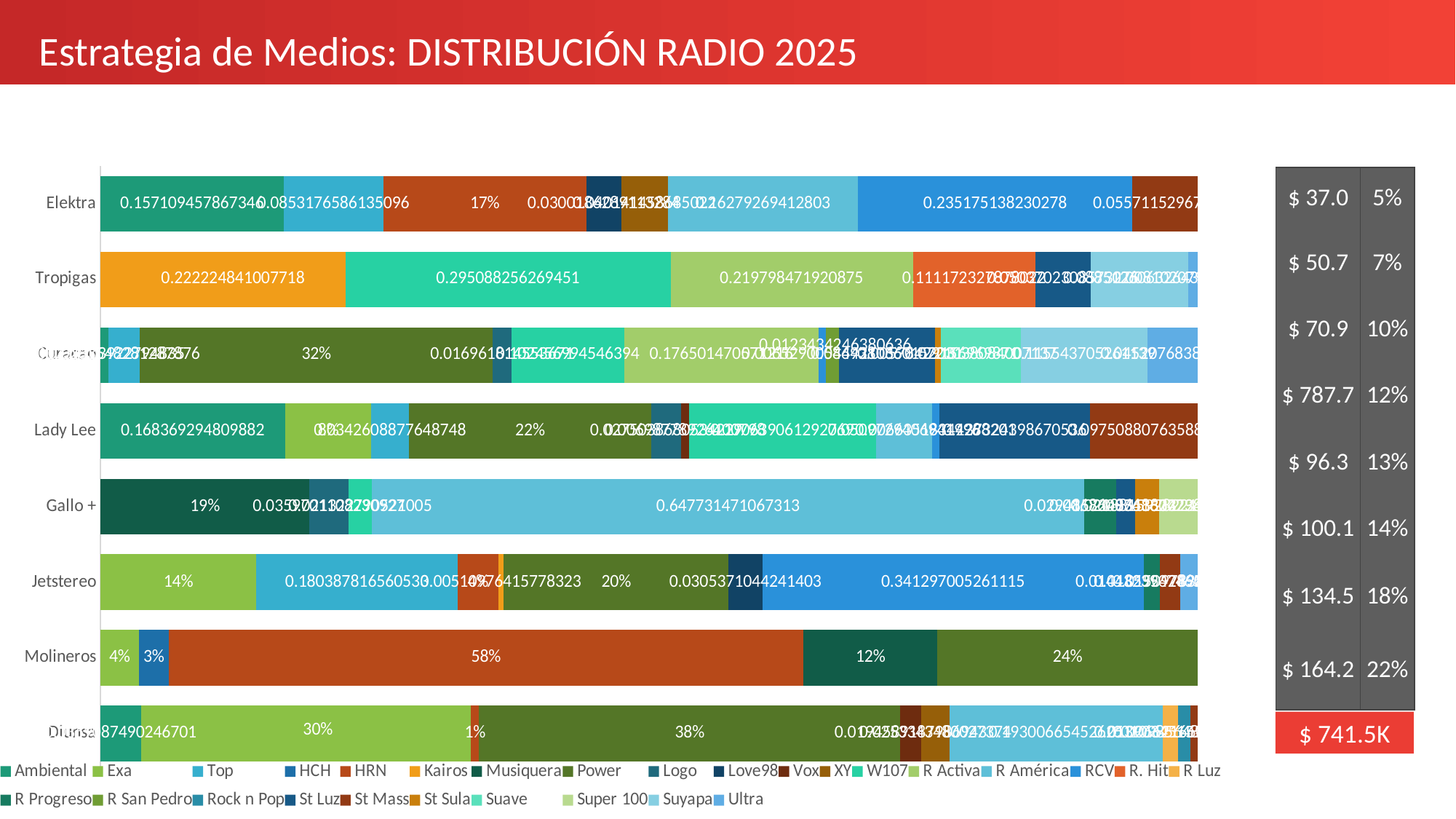
What is the Power share for Diunsa? 38% How many companies (categories) are plotted on the chart? 8 For Molineros, what is the difference between the Power share and the Musiquera share? 12% What is the RCV value for Jetstereo? 0.341297005261115 What kind of chart is shown on the slide? Stacked bar chart For Molineros, which is larger: the Power share or the Musiquera share? Power What is the HRN share for Molineros? 58% Which station has the largest share of the Molineros bar? HRN How many series does the legend list? 28 What is the Power share for Molineros? 24%